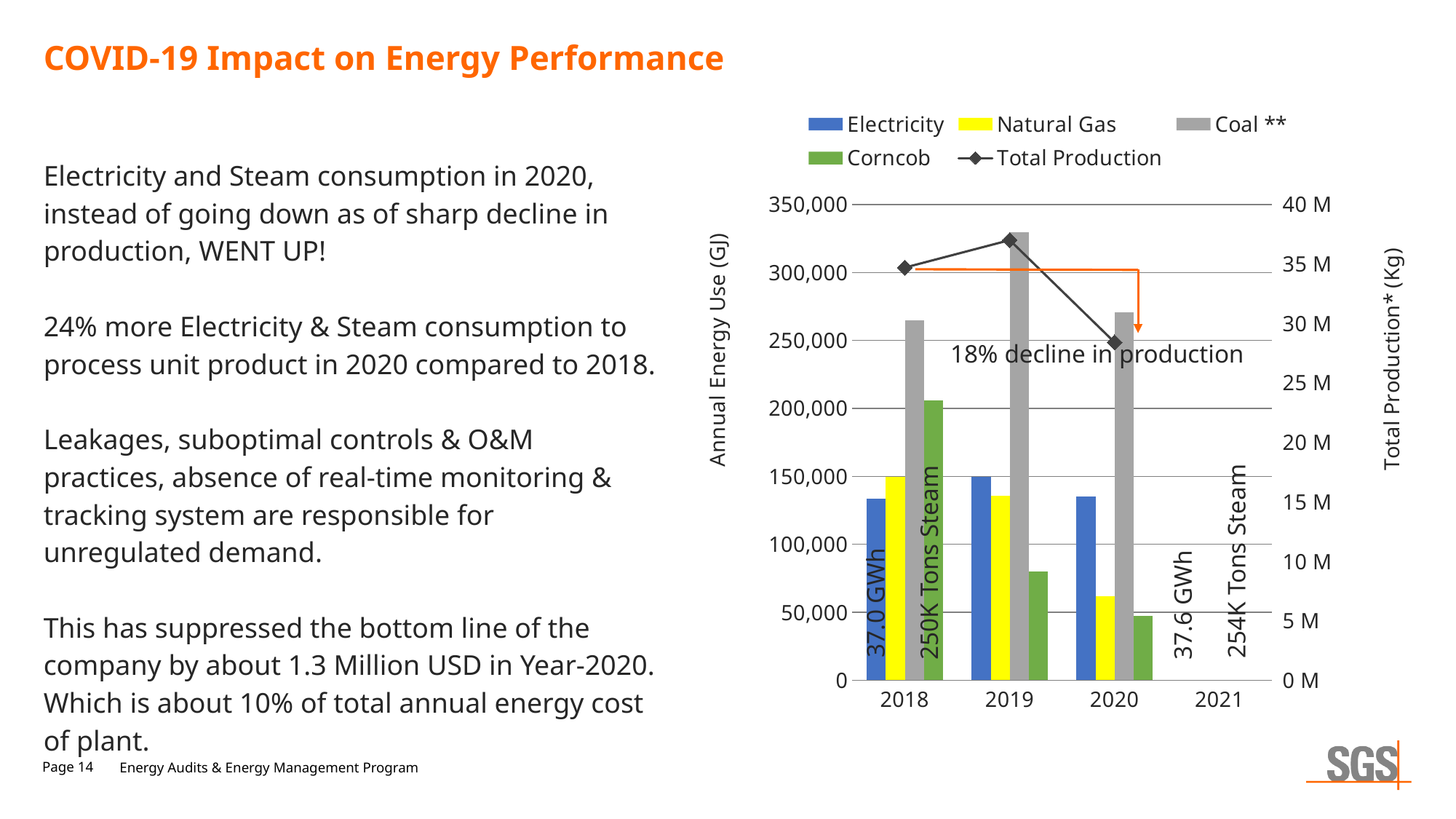
What kind of chart is shown on the slide? Bar chart with a line series Is the Coal ** value for 2019 greater or less than 300,000? greater Is the Corncob value for 2019 greater or less than 100,000? less What is the title of the left vertical axis of the chart? Annual Energy Use (GJ) How many series does the chart legend list? 5 Which is larger, the Corncob value for 2018 or the Corncob value for 2020? 2018 In which year is the Coal ** bar the highest? 2019 Do the Corncob values rise or fall from 2018 to 2020? fall Is the Natural Gas value for 2020 greater or less than 100,000? less How many year labels are shown on the x axis of the chart? 4 In which year is the Corncob bar the highest? 2018 In which year is the Natural Gas bar the lowest? 2020